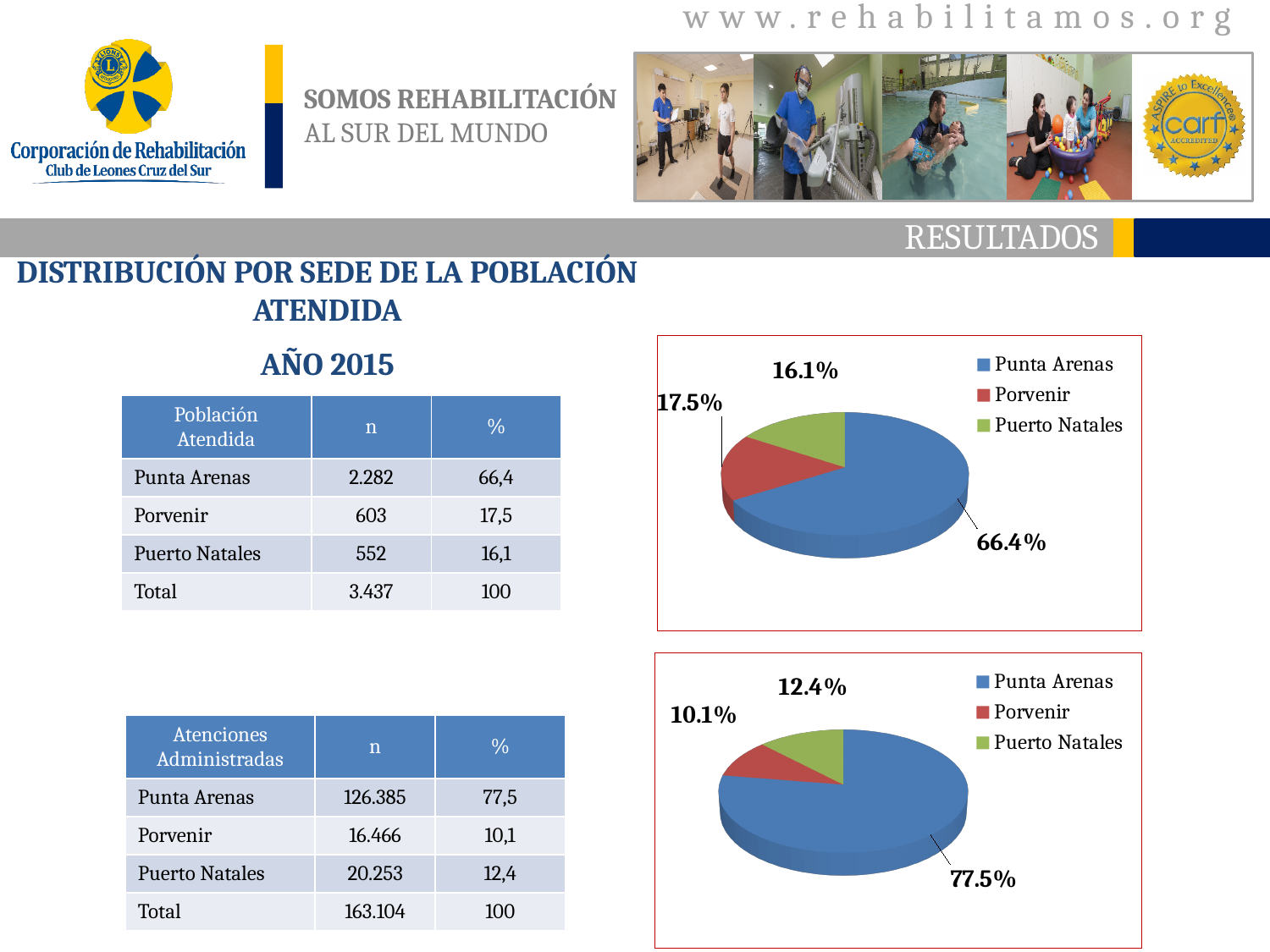
In the bottom pie chart, what percentage is shown for Punta Arenas? 77.5% In the top pie chart, what percentage is shown for Punta Arenas? 66.4% In the bottom pie chart, what percentage is shown for Porvenir? 10.1% In the top pie chart, which category has the largest share? Punta Arenas In the bottom pie chart, which is larger, the share for Porvenir or the share for Puerto Natales? Puerto Natales In the top pie chart, what percentage is shown for Puerto Natales? 16.1% How many categories does the legend of the bottom pie chart list? 3 In the top pie chart, what is the difference between the Punta Arenas share and the Porvenir share? 48.9% What type of chart is the top chart on the slide? Pie chart In the bottom pie chart, which category has the smallest share? Porvenir In the top pie chart, what percentage is shown for Porvenir? 17.5% In the bottom pie chart, what percentage is shown for Puerto Natales? 12.4%